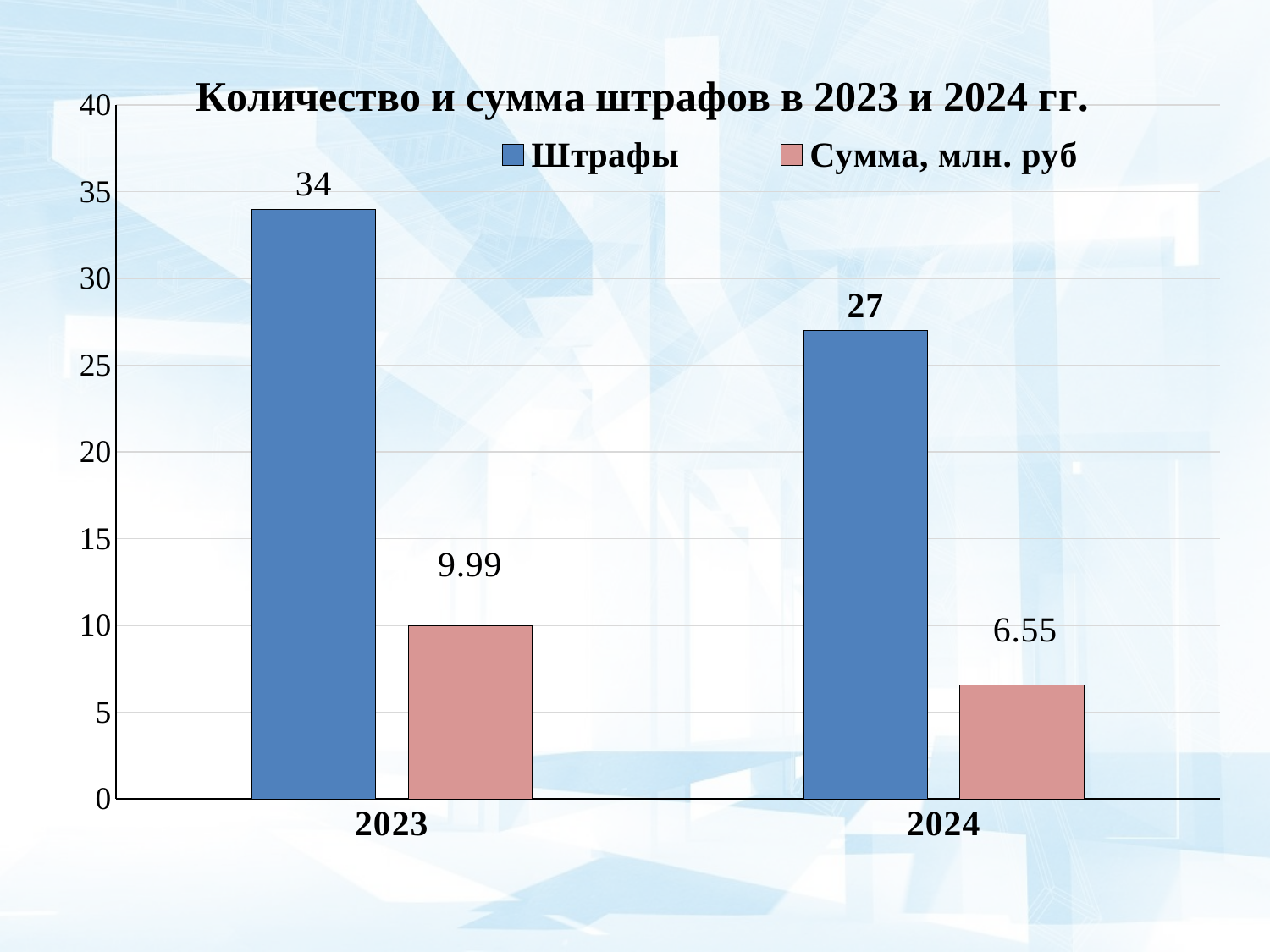
Which year has the lower value for Сумма, млн. руб? 2024 What is the value of Сумма, млн. руб for 2024? 6.55 What is the difference between the Штрафы values for 2023 and 2024? 7 What is the title of the chart? Количество и сумма штрафов в 2023 и 2024 гг. What is the value of Штрафы for 2023? 34 What is the difference between the Сумма, млн. руб values for 2023 and 2024? 3.44 Which year has the higher value for Штрафы? 2023 What is the value of Штрафы for 2024? 27 What is the value of Сумма, млн. руб for 2023? 9.99 How many series does the legend list? 2 What kind of chart is shown on the slide? Bar chart Is the value of Штрафы for 2024 greater or less than 25? greater